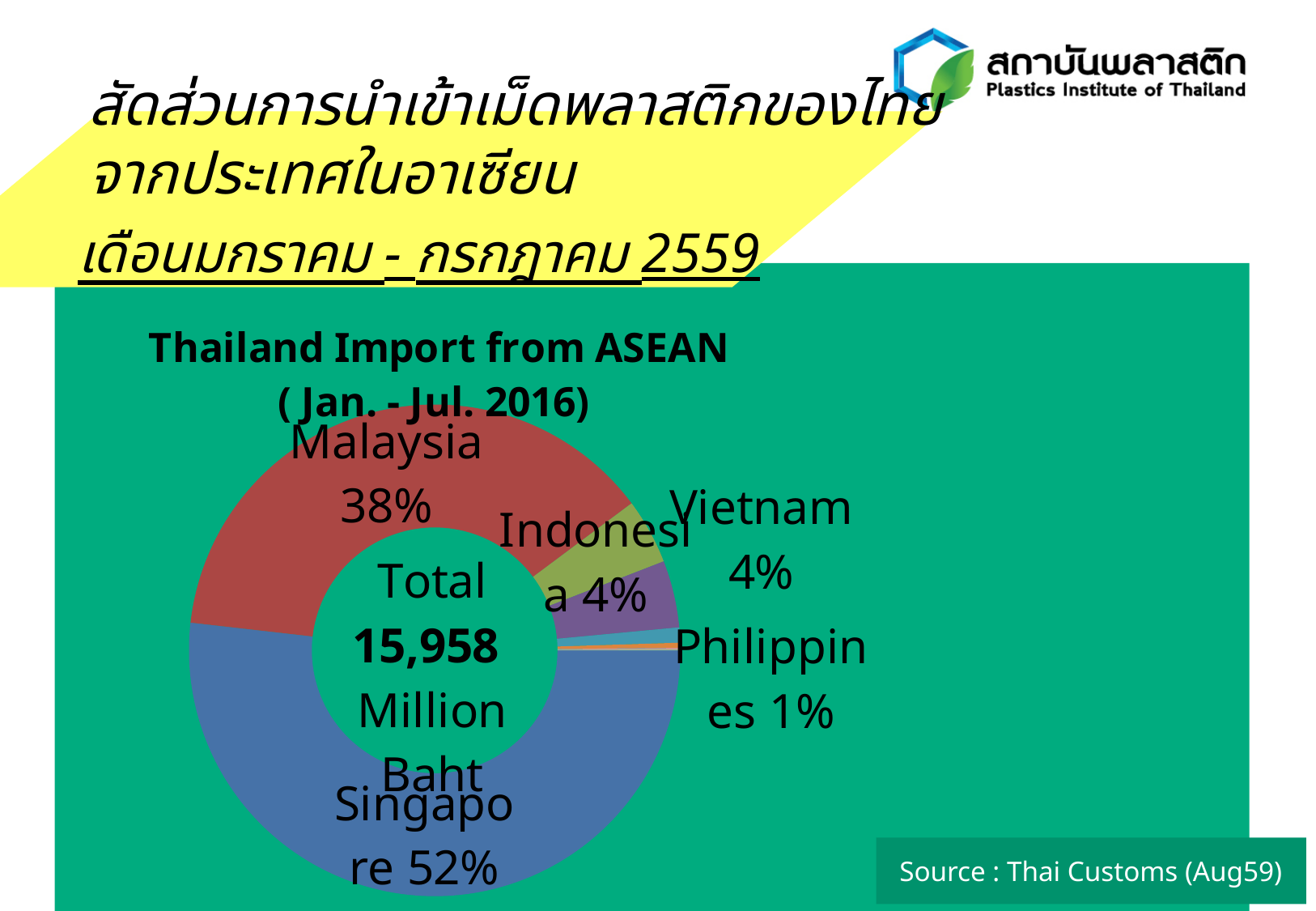
What percentage is shown for Vietnam? 4% Which labeled country has the smallest share of Thailand's imports from ASEAN? Philippines What percentage is shown for the Philippines? 1% What is the title of the chart? Thailand Import from ASEAN ( Jan. - Jul. 2016) What share of Thailand's imports from ASEAN comes from Malaysia? 38% Which country has the largest share of Thailand's imports from ASEAN? Singapore What percentage is shown for Indonesia? 4% How many percentage points larger is Singapore's share than Malaysia's? 14% What share of Thailand's imports from ASEAN comes from Singapore? 52% Which has a larger share, Malaysia or Singapore? Singapore What kind of chart is shown on the slide? Doughnut (pie) chart What total value is shown in the centre of the chart? 15,958 Million Baht